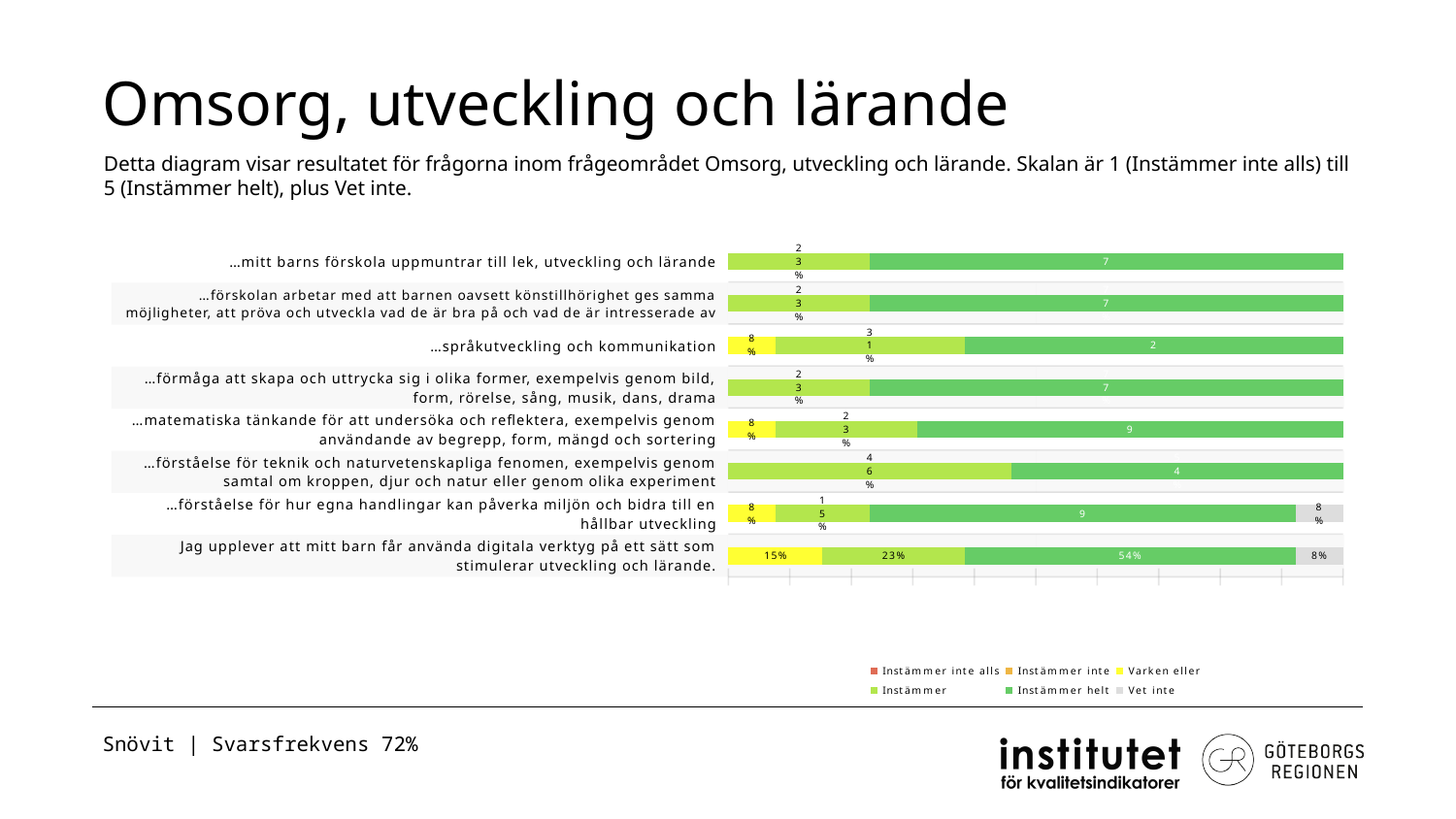
Which legend entry is shown in grey? Vet inte What is the value for Instämmer helt for the statement 'Jag upplever att mitt barn får använda digitala verktyg på ett sätt som stimulerar utveckling och lärande.'? 54% For the statement about digitala verktyg, what is the difference between the Instämmer helt value and the Instämmer value? 31 percentage points What is the value for Instämmer for the statement 'Jag upplever att mitt barn får använda digitala verktyg på ett sätt som stimulerar utveckling och lärande.'? 23% What is the value for Vet inte for the statement 'Jag upplever att mitt barn får använda digitala verktyg på ett sätt som stimulerar utveckling och lärande.'? 8% For the statement about digitala verktyg, which is larger: Instämmer helt or Instämmer? Instämmer helt For the statement about digitala verktyg, which response category has the highest share? Instämmer helt What is the total of the labelled segments in the bar for the statement about digitala verktyg? 100% How many question statements (categories) are plotted in the chart? 8 What kind of chart is shown on the slide? bar chart What is the value for Varken eller for the statement 'Jag upplever att mitt barn får använda digitala verktyg på ett sätt som stimulerar utveckling och lärande.'? 15% How many series does the legend list? 6